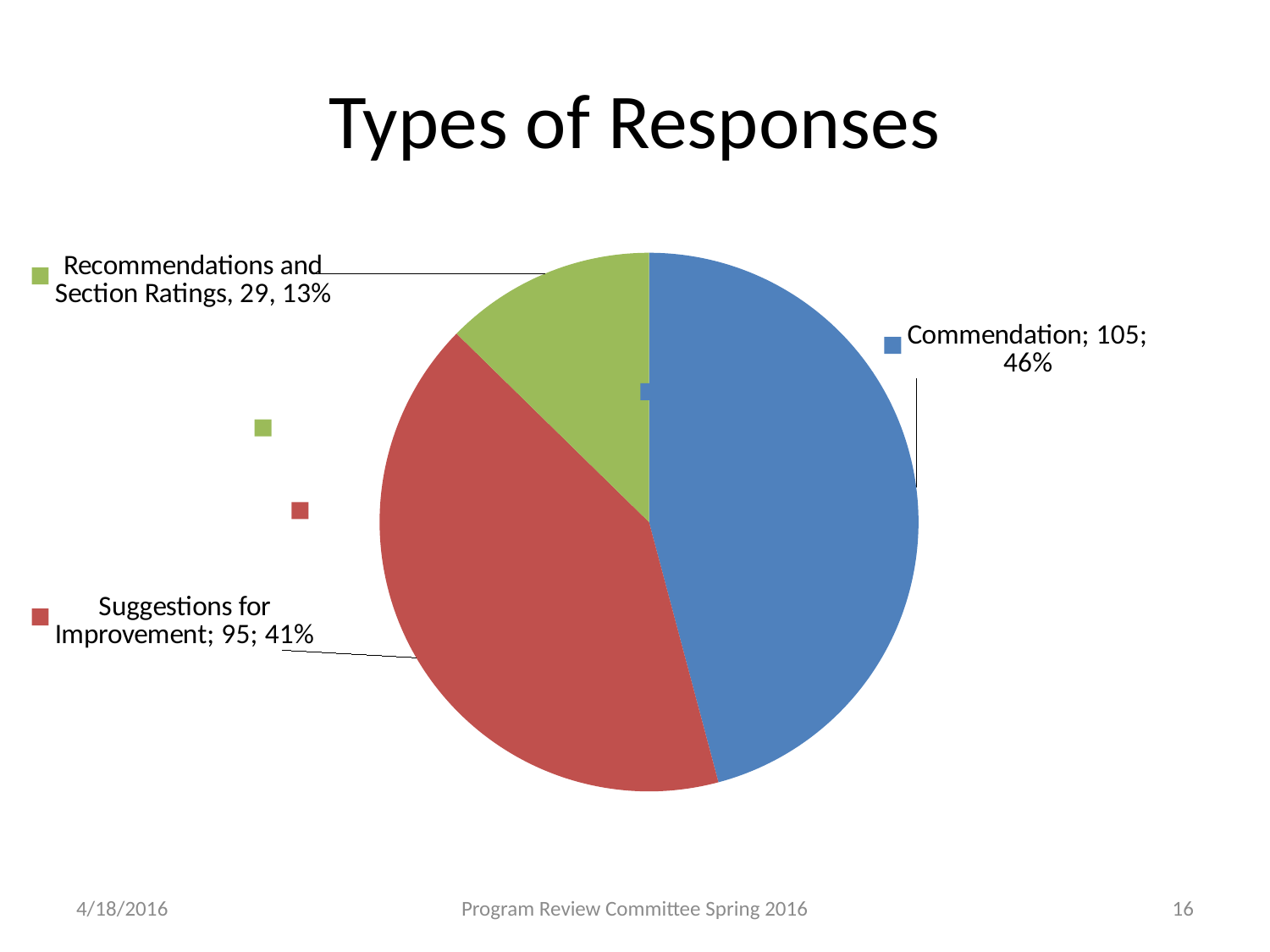
Which category has the largest slice? Commendation Which category has the smallest slice? Recommendations and Section Ratings What is the value for Recommendations and Section Ratings? 29 What type of chart is shown on the slide? pie chart What share of the pie does Commendation represent? 46% What share of the pie does Recommendations and Section Ratings represent? 13% What is the value for Commendation? 105 What is the value for Suggestions for Improvement? 95 What is the title of the chart? Types of Responses Which is larger, the value for Suggestions for Improvement or the value for Recommendations and Section Ratings? Suggestions for Improvement How many slices does the pie chart have? 3 What is the difference between the values for Commendation and Suggestions for Improvement? 10